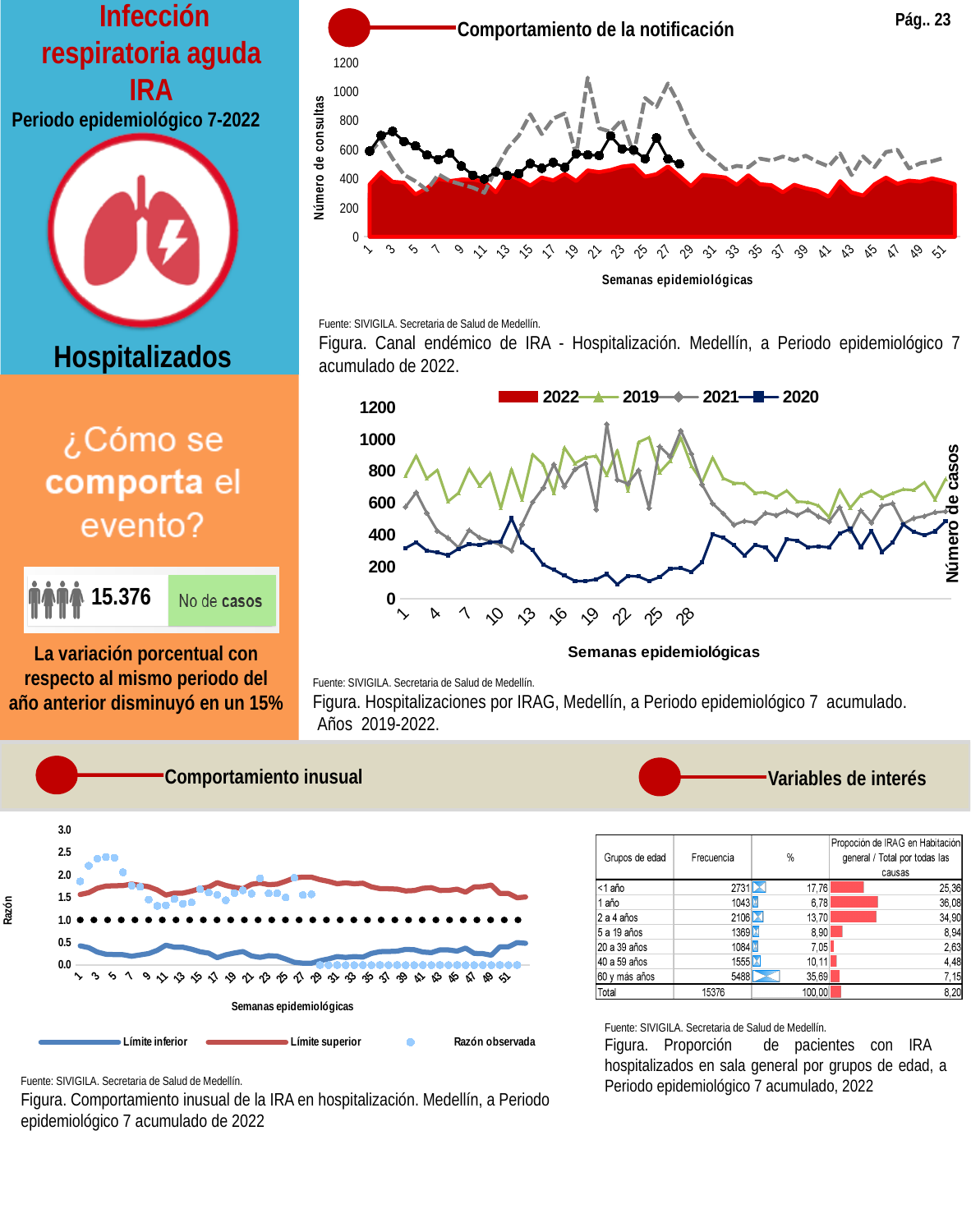
In the 'Comportamiento inusual' chart, how many entries does the legend list? 3 In the 'Comportamiento inusual' chart, what are the legend entries? Límite inferior, Límite superior, Razón observada What kind of chart is the 'Hospitalizaciones por IRAG' chart? line chart In the 'Comportamiento inusual' chart, is the Límite inferior at week 1 greater or less than 1.0? less In the 'Hospitalizaciones por IRAG' chart, which years are listed in the legend? 2022, 2019, 2021, 2020 In the 'Hospitalizaciones por IRAG' chart, how many series does the legend list? 4 In the 'Comportamiento inusual' chart, is the Razón observada at week 4 greater or less than 2.0? greater In the 'Hospitalizaciones por IRAG' chart, is the value for 2020 at week 1 greater or less than 600? less In the 'Canal endémico de IRA' chart at the top, what is the label of the x axis? Semanas epidemiológicas In the 'Hospitalizaciones por IRAG' chart, which series is lower at week 1, 2019 or 2020? 2020